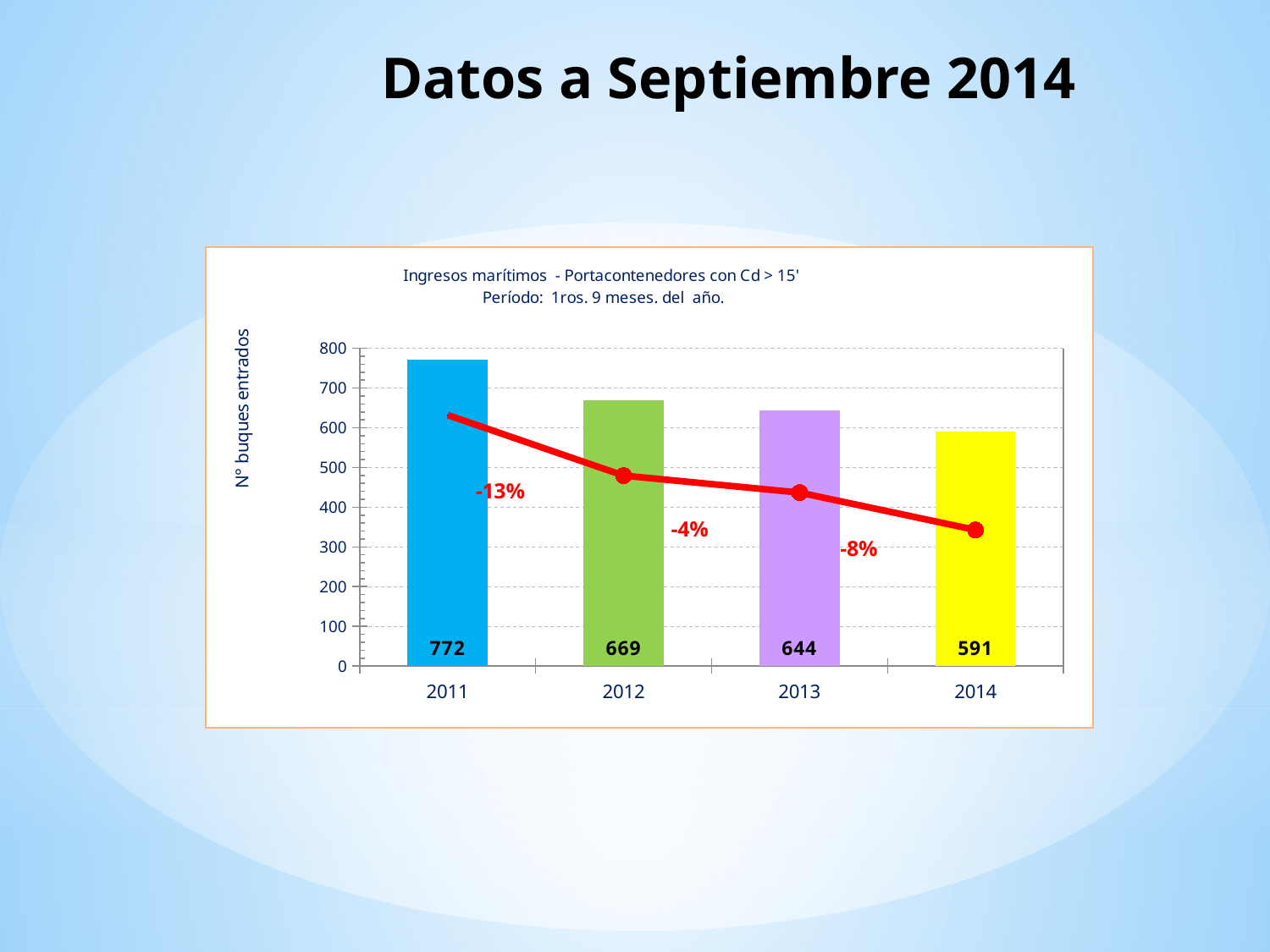
Which year has the lowest number of ships entered? 2014 What is the y-axis title of the chart? N° buques entrados What is the value shown for 2014? 591 What percentage change is labelled on the red line between 2011 and 2012? -13% What is the difference between the 2011 value and the 2012 value? 103 What is the difference between the 2013 value and the 2014 value? 53 What is the number of ships entered (N° buques entrados) for 2011? 772 Do the bar values rise or fall from 2011 to 2014? fall What is the value shown for 2013? 644 Which year has the highest number of ships entered? 2011 Which is larger, the value for 2012 or the value for 2013? 2012 How many years are shown on the x axis? 4